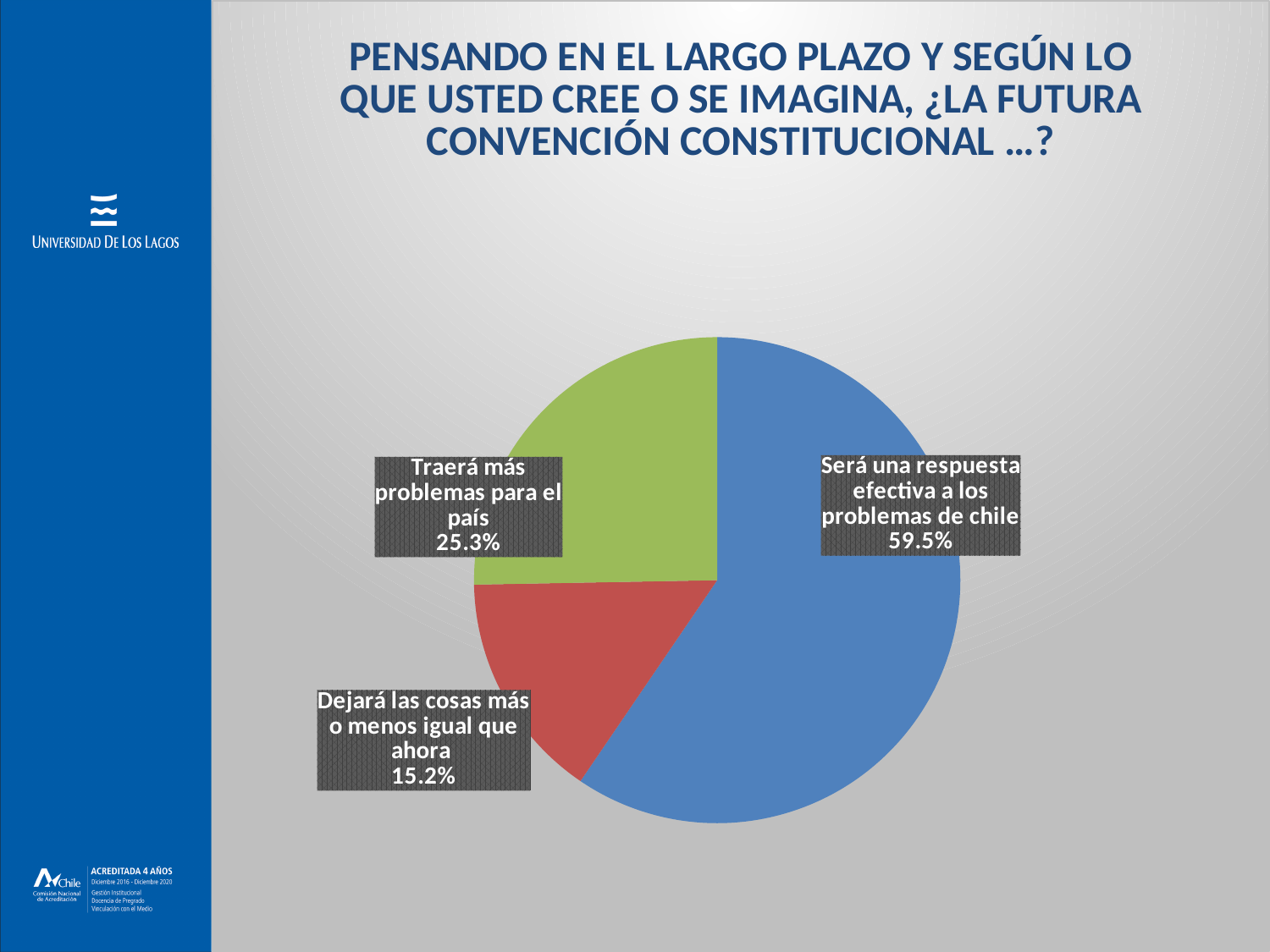
What colour is the slice for 'Será una respuesta efectiva a los problemas de chile'? Blue How many slices does the pie chart have? 3 What percentage of respondents said it 'Traerá más problemas para el país'? 25.3% What percentage of respondents said the future constitutional convention 'Será una respuesta efectiva a los problemas de chile'? 59.5% What kind of chart is shown on the slide? Pie chart What colour is the slice for 'Traerá más problemas para el país'? Green Which response has the smallest share of the pie? Dejará las cosas más o menos igual que ahora Which is larger: the share for 'Traerá más problemas para el país' or for 'Dejará las cosas más o menos igual que ahora'? Traerá más problemas para el país What percentage of respondents said it 'Dejará las cosas más o menos igual que ahora'? 15.2% What is the difference in percentage points between 'Traerá más problemas para el país' and 'Dejará las cosas más o menos igual que ahora'? 10.1 Which response has the largest share of the pie? Será una respuesta efectiva a los problemas de chile What is the difference in percentage points between 'Será una respuesta efectiva a los problemas de chile' and 'Traerá más problemas para el país'? 34.2